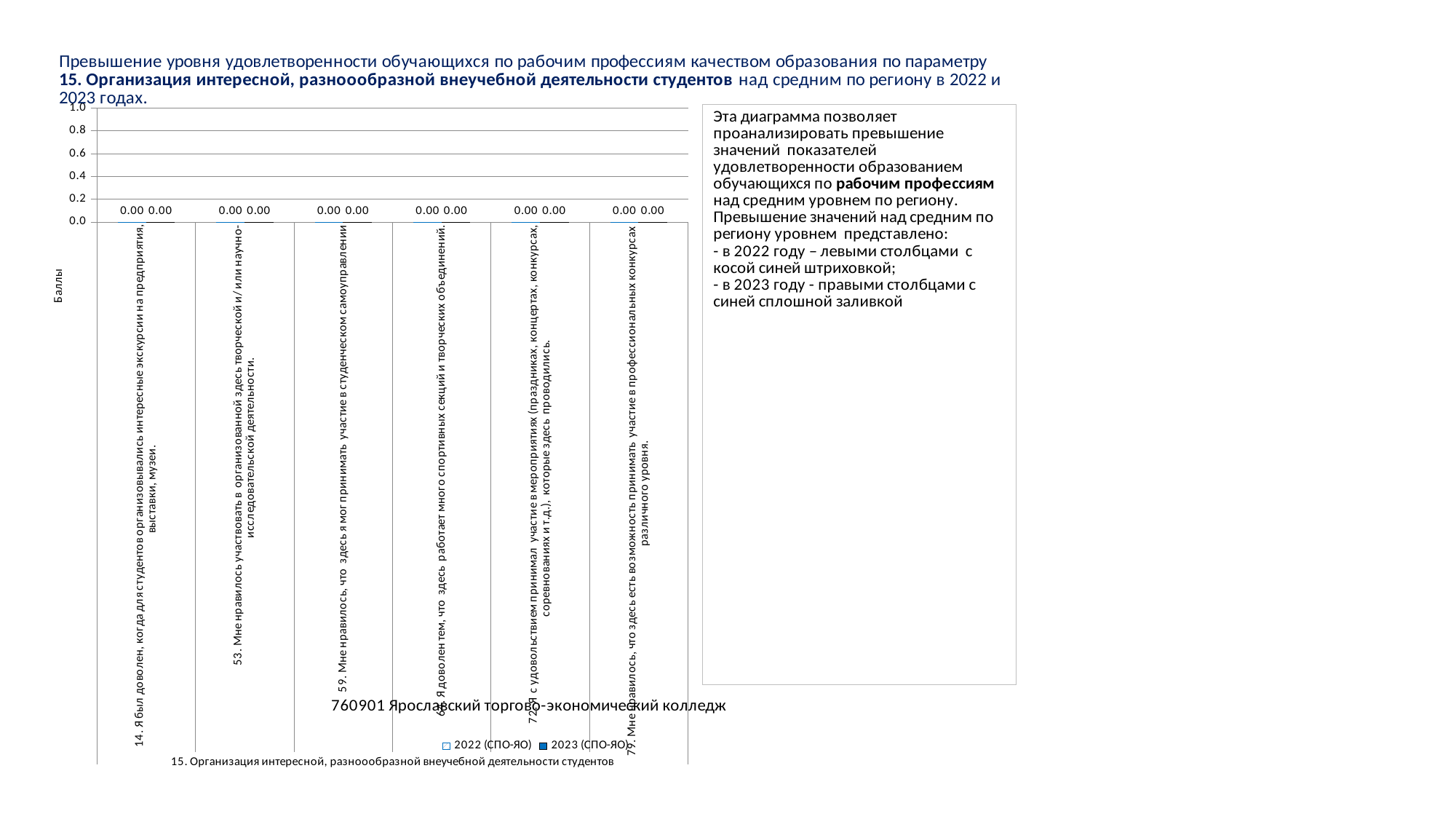
What is the value for the 2023 (СПО-ЯО) series for item 79 (participation in professional competitions)? 0.00 What are the two series named in the chart legend? 2022 (СПО-ЯО) and 2023 (СПО-ЯО) Do the values of the 2022 (СПО-ЯО) series rise, fall, or stay flat across the categories on the x axis? stay flat What is the value for the 2022 (СПО-ЯО) series for item 14 (excursions to enterprises, exhibitions, museums)? 0.00 What is the value for the 2023 (СПО-ЯО) series for item 53 (creative and/or research activity)? 0.00 How many series does the chart legend list? 2 What is the difference between the 2022 (СПО-ЯО) and 2023 (СПО-ЯО) values for item 72 (participation in events such as holidays, concerts, competitions)? 0.00 What is the label of the chart's vertical axis? Баллы What type of chart is shown on the slide? Bar chart What is the value for the 2022 (СПО-ЯО) series for item 59 (participation in student self-government)? 0.00 How many categories (survey items) are plotted on the x axis of the chart? 6